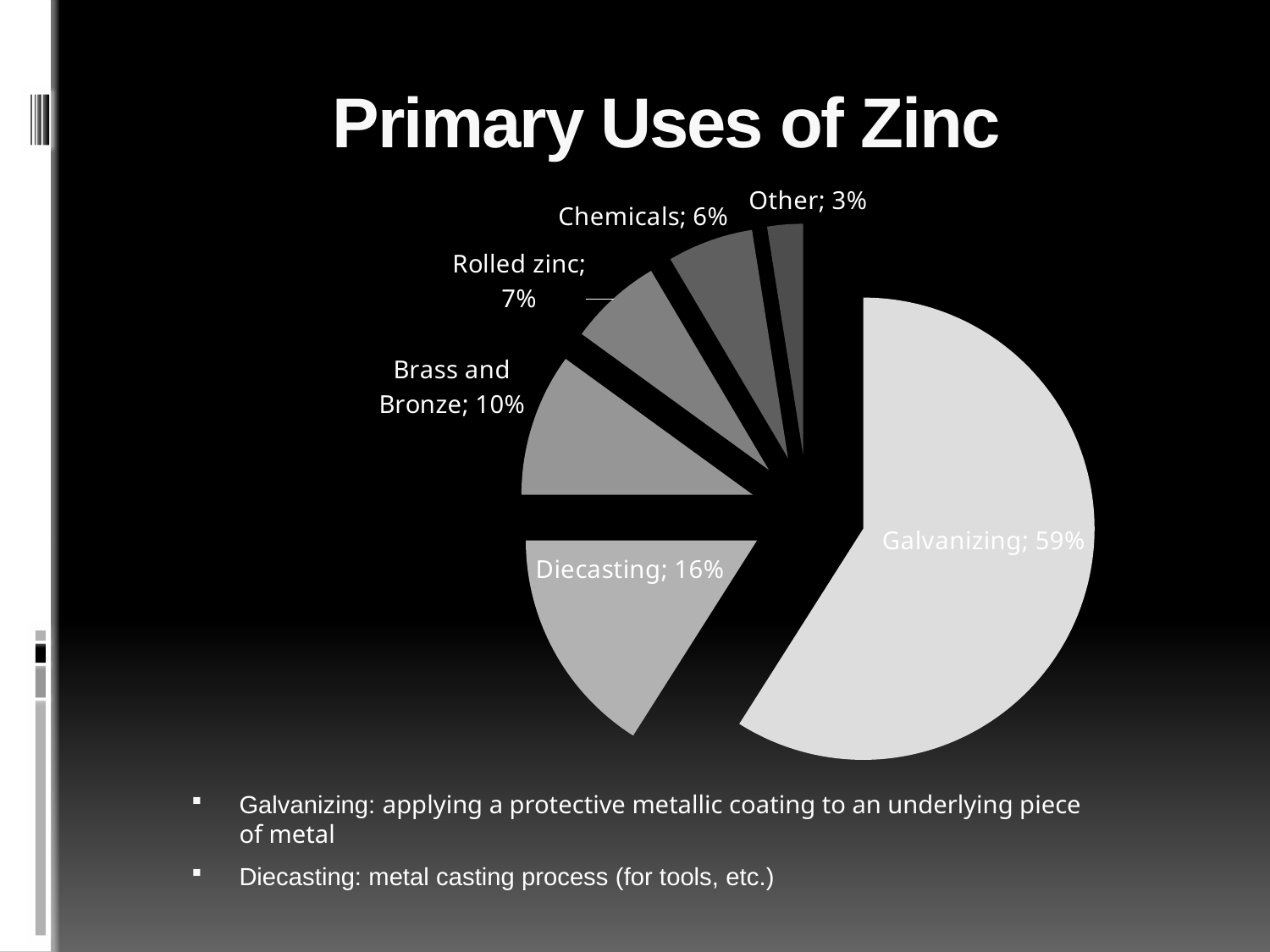
How many slices does the pie chart have? 6 What share of zinc use is Brass and Bronze? 10% Which use has the largest share of the pie? Galvanizing Which use has the smallest share of the pie? Other Which is larger, the share for Brass and Bronze or the share for Rolled zinc? Brass and Bronze What share of zinc use is Galvanizing? 59% What kind of chart is shown on the slide? pie chart What share of zinc use is Diecasting? 16% What share of zinc use is Rolled zinc? 7% What is the difference in percentage points between Galvanizing and Diecasting? 43 What is the title of the chart? Primary Uses of Zinc What share of zinc use is Chemicals? 6%